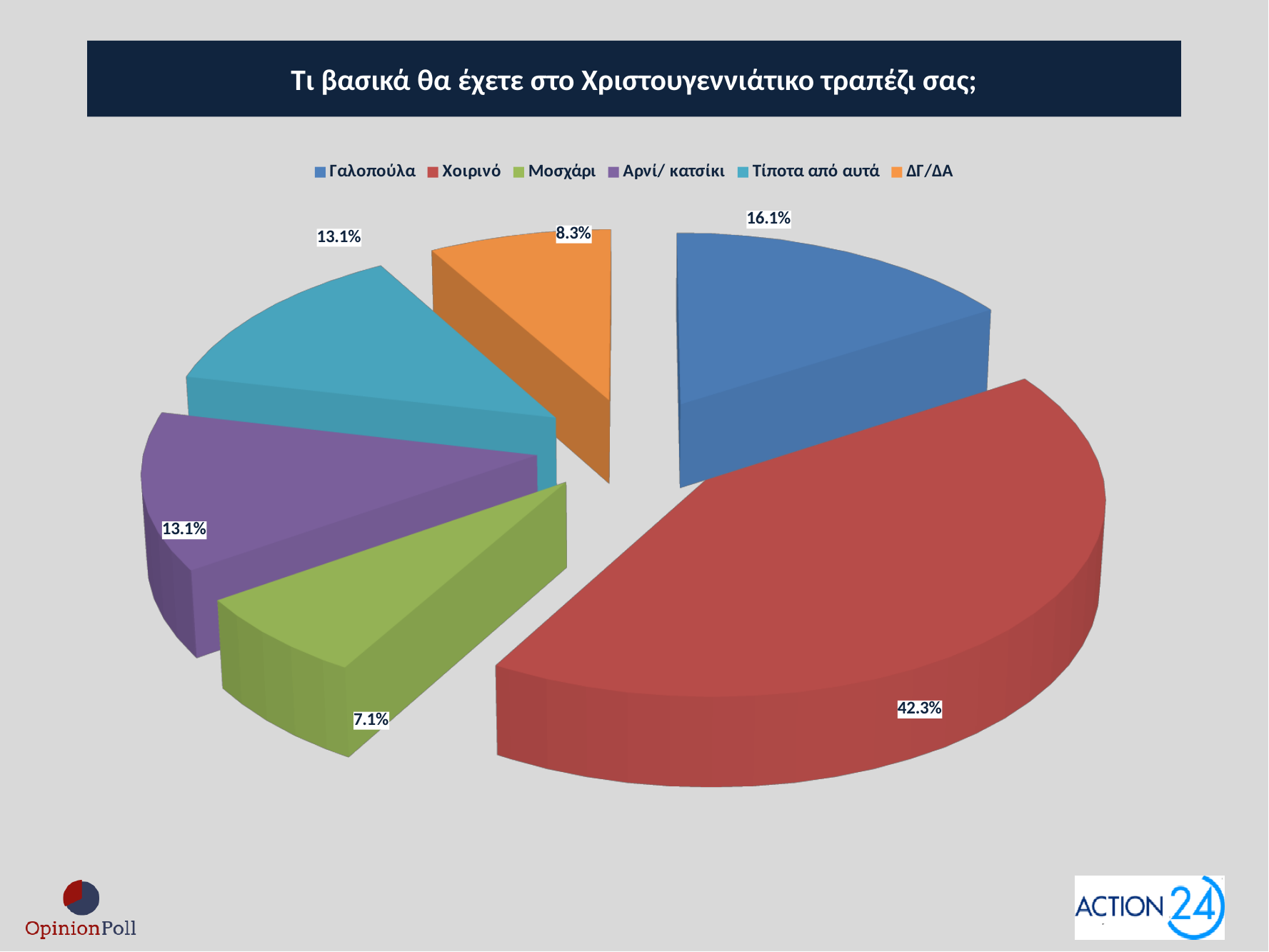
What percentage is shown for Χοιρινό? 42.3% What percentage is shown for Μοσχάρι? 7.1% What is the title of the chart? Τι βασικά θα έχετε στο Χριστουγεννιάτικο τραπέζι σας; Which category has the smallest slice of the pie? Μοσχάρι What percentage is shown for ΔΓ/ΔΑ? 8.3% What percentage is shown for Τίποτα από αυτά? 13.1% Which is larger, the share for Γαλοπούλα or the share for ΔΓ/ΔΑ? Γαλοπούλα What percentage is shown for Γαλοπούλα? 16.1% How many categories does the legend list? 6 Which category has the largest slice of the pie? Χοιρινό What is the difference in percentage points between Χοιρινό and Γαλοπούλα? 26.2 What kind of chart is shown on the slide? pie chart